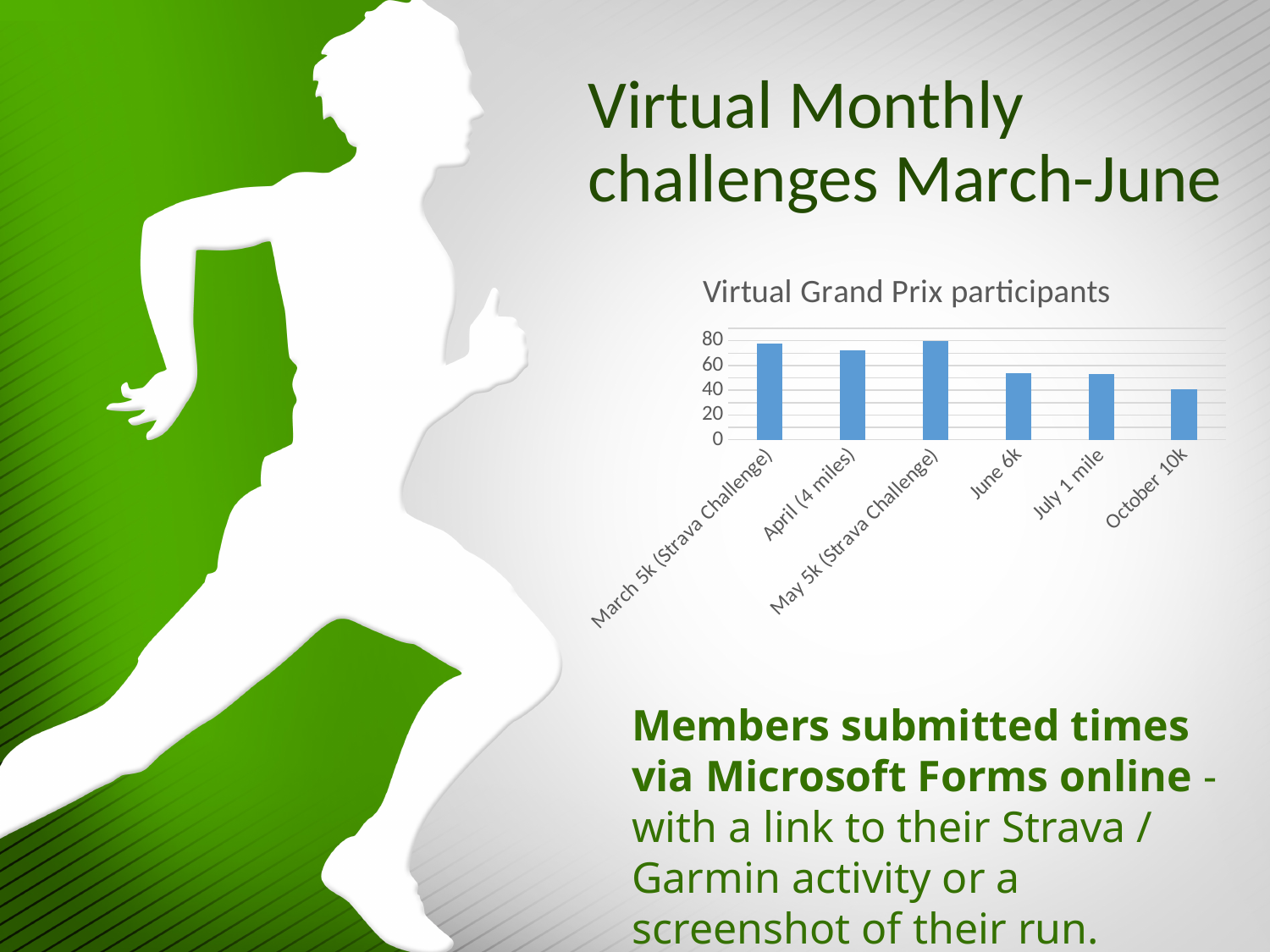
Is the value for April (4 miles) greater or less than 60? greater Do participant numbers generally rise or fall from the first event to the last event along the x axis? fall Is the value for June 6k greater or less than 60? less Is the value for June 6k greater or less than 40? greater What kind of chart is shown on the slide? bar chart Which has more participants, March 5k (Strava Challenge) or June 6k? March 5k (Strava Challenge) How many categories (events) are shown in the chart? 6 Which event has the lowest number of participants? October 10k What is the title of the chart on the slide? Virtual Grand Prix participants